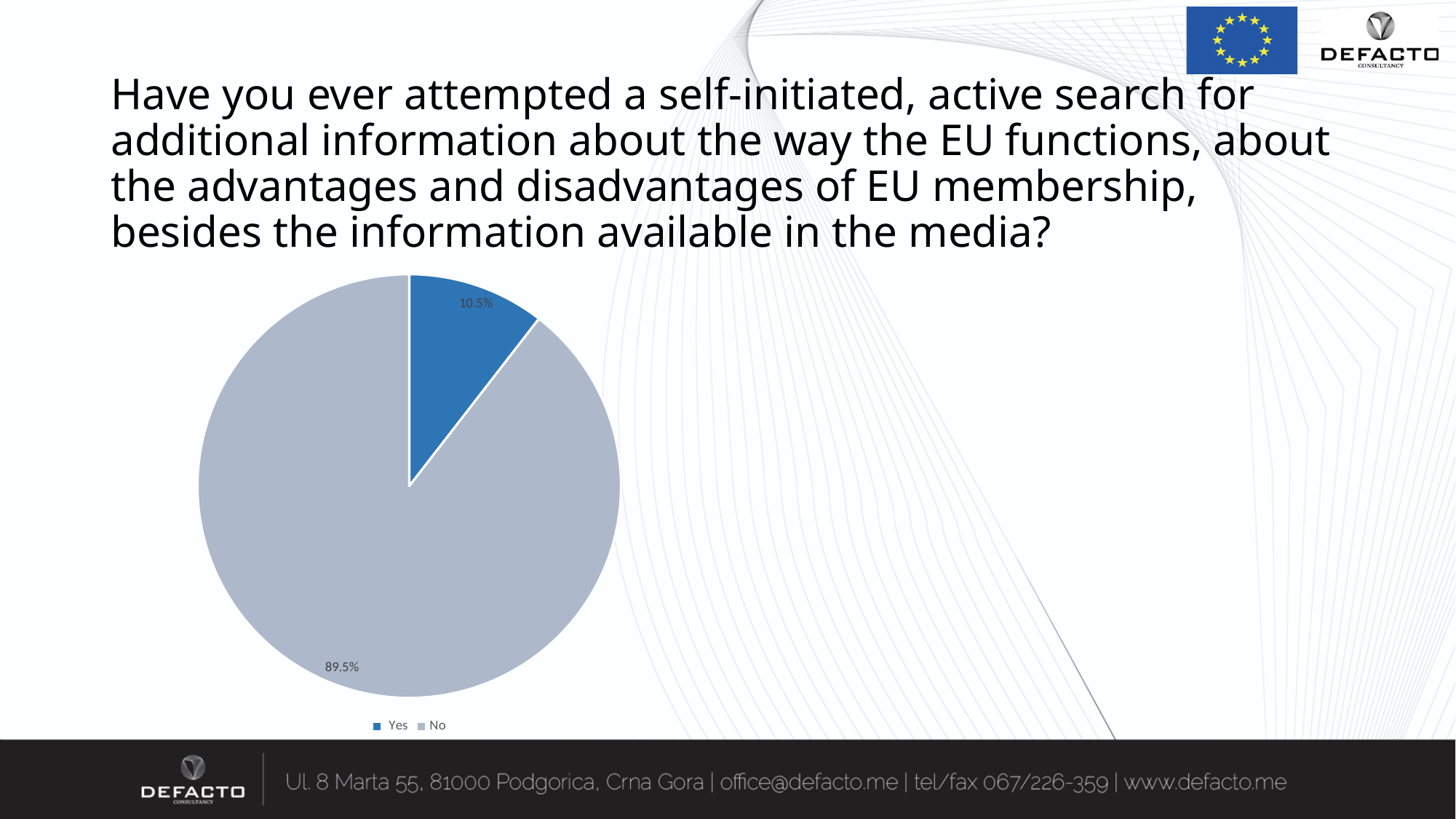
What share of the pie does the Yes slice represent? 10.5% What is the difference in percentage points between the No and Yes shares? 79 percentage points Which response has the smallest share of the pie? Yes What colour is the Yes slice in the pie chart? Blue What percentage of respondents answered Yes? 10.5% Which is larger, the share for Yes or the share for No? No What are the two legend entries of the chart? Yes and No How many categories does the pie chart show? 2 What kind of chart is shown on the slide? Pie chart Which response has the largest share of the pie? No What percentage of respondents answered No? 89.5%